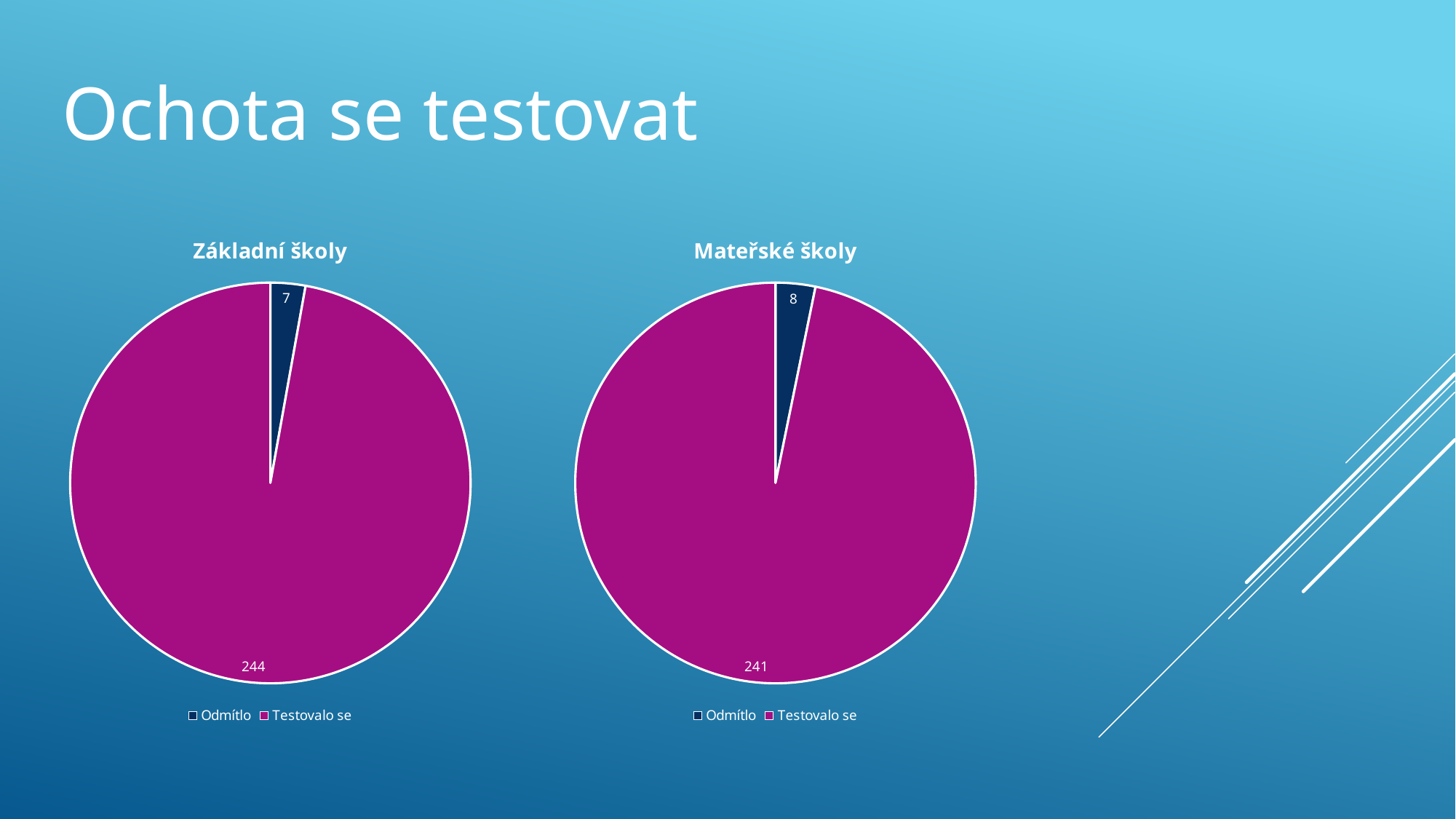
Which chart has the larger value for Odmítlo, 'Základní školy' or 'Mateřské školy'? Mateřské školy In the 'Základní školy' chart, what is the value for Odmítlo? 7 In the 'Základní školy' chart, what is the difference between Testovalo se and Odmítlo? 237 How many categories does the legend of the 'Mateřské školy' chart list? 2 What is the title of the chart on the left? Základní školy In the 'Mateřské školy' chart, what is the value for Odmítlo? 8 In the 'Mateřské školy' chart, what is the value for Testovalo se? 241 In the 'Základní školy' chart, which category has the largest slice? Testovalo se In the 'Mateřské školy' chart, what is the total of all slices? 249 In the 'Mateřské školy' chart, which category has the smallest slice? Odmítlo What kind of chart is the 'Základní školy' chart? Pie chart In the 'Základní školy' chart, what is the value for Testovalo se? 244